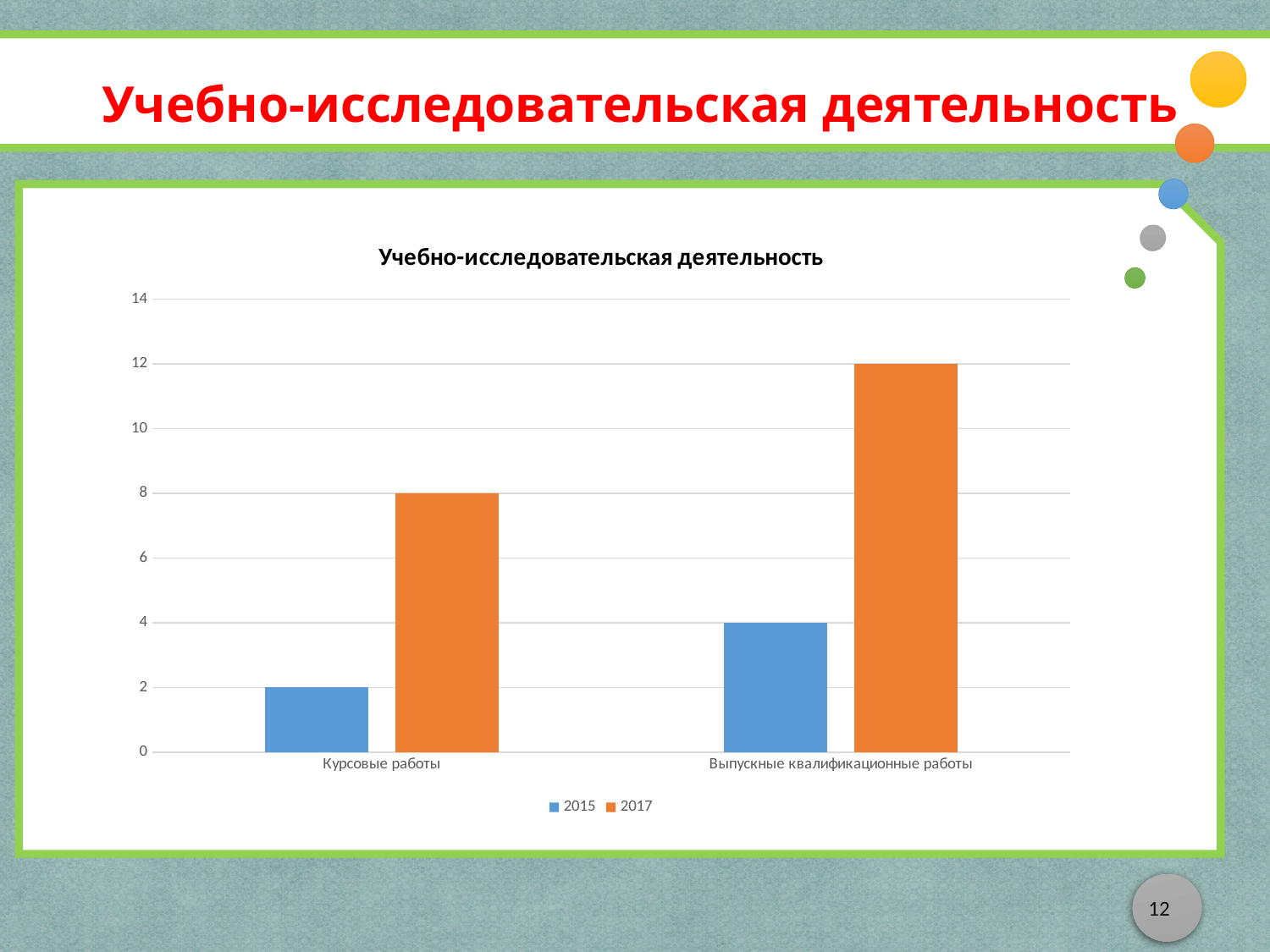
Which is larger for Курсовые работы: the 2015 value or the 2017 value? 2017 What is the value for Выпускные квалификационные работы in the 2015 series? 4 How many categories are shown on the x axis? 2 What is the value for Выпускные квалификационные работы in the 2017 series? 12 What is the value for Курсовые работы in the 2015 series? 2 What is the value for Курсовые работы in the 2017 series? 8 Which category has the lowest value in the 2015 series? Курсовые работы What kind of chart is shown on the slide? bar chart How many series does the legend list? 2 What is the difference between the 2017 and 2015 values for Выпускные квалификационные работы? 8 Which category has the highest value in the 2017 series? Выпускные квалификационные работы Is the 2017 value for Выпускные квалификационные работы greater or less than 10? greater